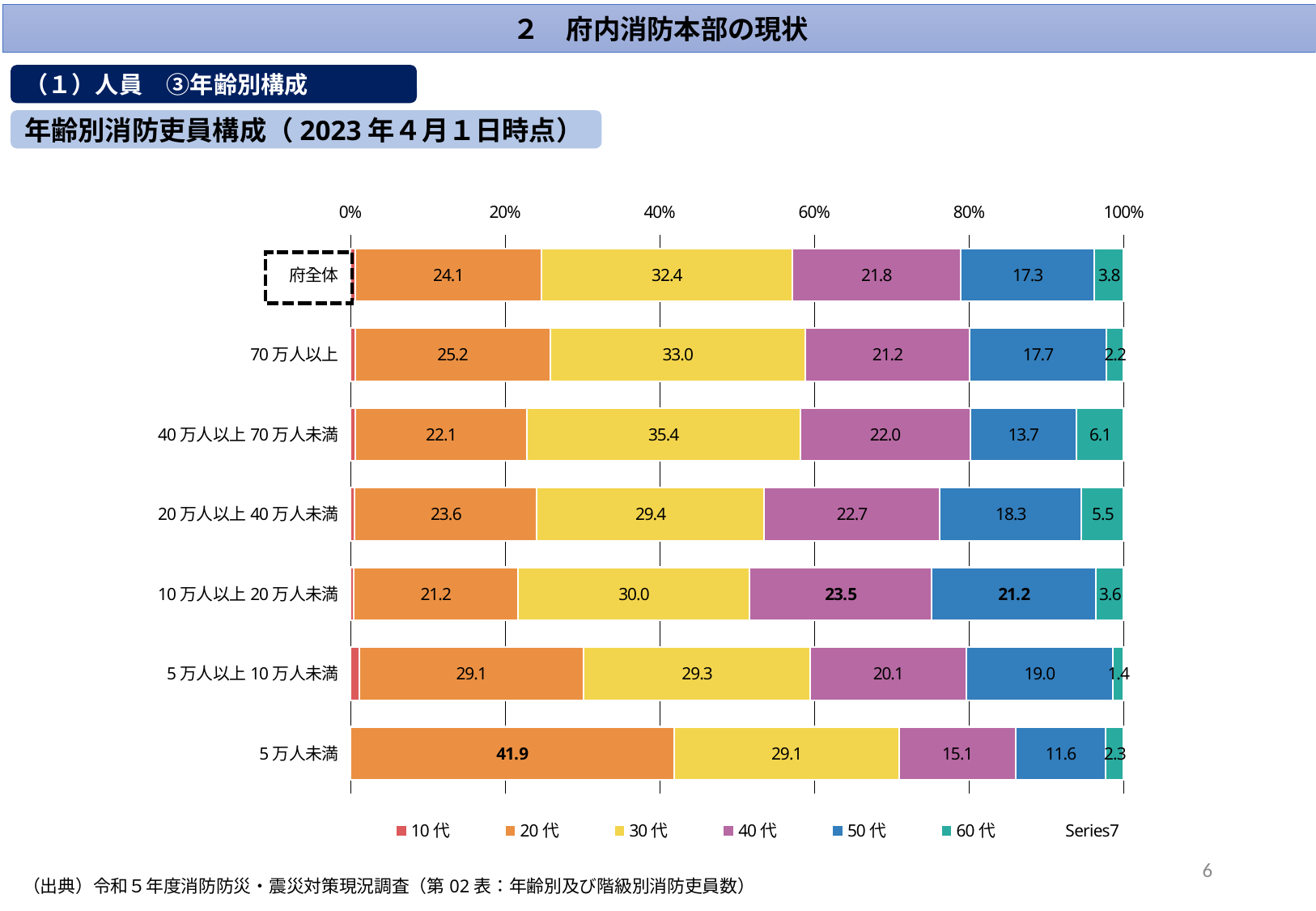
Which row has the highest value for 30代? 40万人以上70万人未満 Which row has the highest value for 20代? 5万人未満 What kind of chart is shown on the slide? Stacked bar chart In the 府全体 row, what is the difference between the 30代 value and the 20代 value? 8.3 What is the value for 30代 in the 府全体 row? 32.4 How many series does the legend list? 7 What is the value for 50代 in the 40万人以上70万人未満 row? 13.7 How many categories (rows) are plotted in the chart? 7 Which row has the lowest value for 60代? 5万人以上10万人未満 What is the title shown above the chart? 年齢別消防吏員構成（2023年4月1日時点） What is the value for 60代 in the 5万人以上10万人未満 row? 1.4 Which is larger: the 50代 value for 10万人以上20万人未満 or the 50代 value for 5万人未満? 10万人以上20万人未満